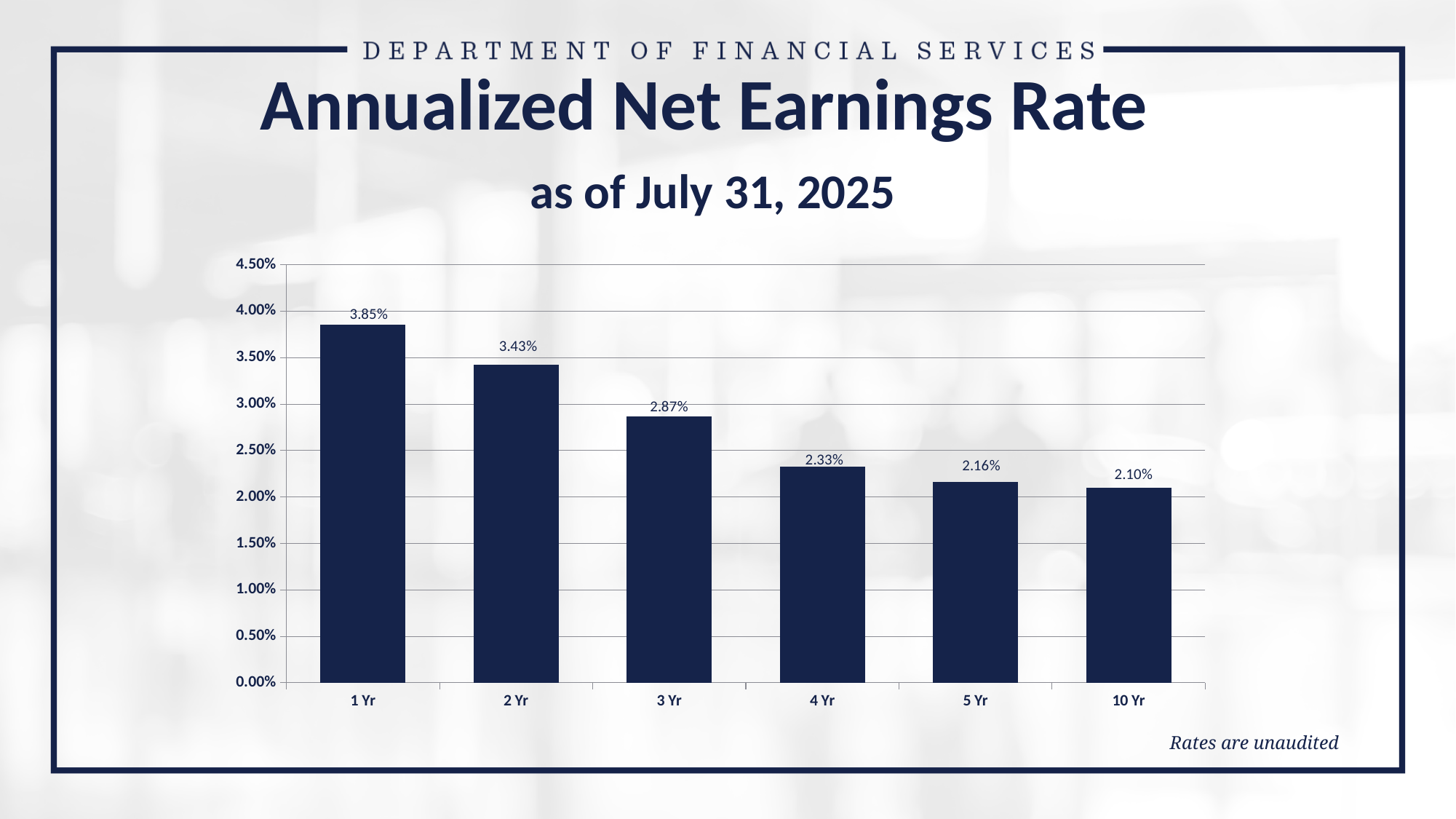
What kind of chart is shown on the slide? Bar chart What is the difference between the 1 Yr and 2 Yr annualized net earnings rates? 0.42% What is the annualized net earnings rate for 10 Yr? 2.10% Is the value for 5 Yr greater or less than 2.50%? less How many periods are shown on the x axis? 6 What is the annualized net earnings rate for 1 Yr? 3.85% Do the annualized net earnings rates rise or fall from 1 Yr to 10 Yr? Fall Which period has the highest annualized net earnings rate? 1 Yr What is the difference between the 4 Yr and 5 Yr annualized net earnings rates? 0.17% Which is larger, the 2 Yr rate or the 3 Yr rate? 2 Yr Which period has the lowest annualized net earnings rate? 10 Yr What is the annualized net earnings rate for 3 Yr? 2.87%